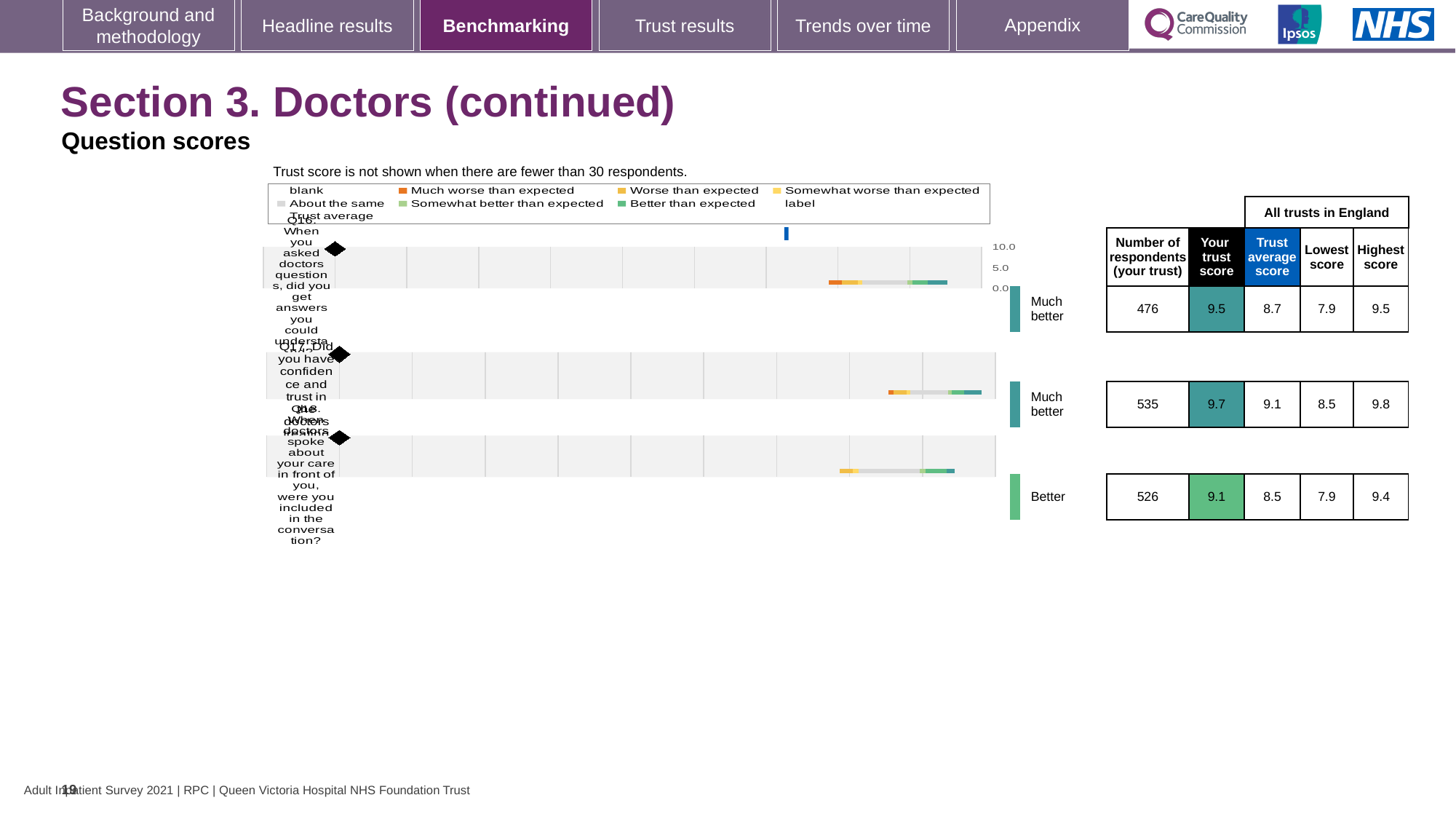
For Q16, which is larger: the 'Your trust score' or the trust average score? Your trust score (9.5) What is the difference between the 'Your trust score' and the trust average score for Q17? 0.6 What is the trust average score for Q16 (When you asked doctors questions, did you get answers you could understand)? 8.7 How many questions (categories) are plotted in the question scores chart? 3 Which question has the highest 'Your trust score'? Q17 How many respondents from your trust answered Q18? 526 Is the 'Your trust score' for Q16 greater or less than 5.0? greater What kind of chart is used to show the question scores for Q16, Q17 and Q18? bar chart Which question has the lowest 'Your trust score'? Q18 What benchmark rating label is shown next to Q18? Better What is the highest score across all trusts in England for Q17? 9.8 What is the 'Your trust score' for Q17 (Did you have confidence and trust in the doctors treating you)? 9.7